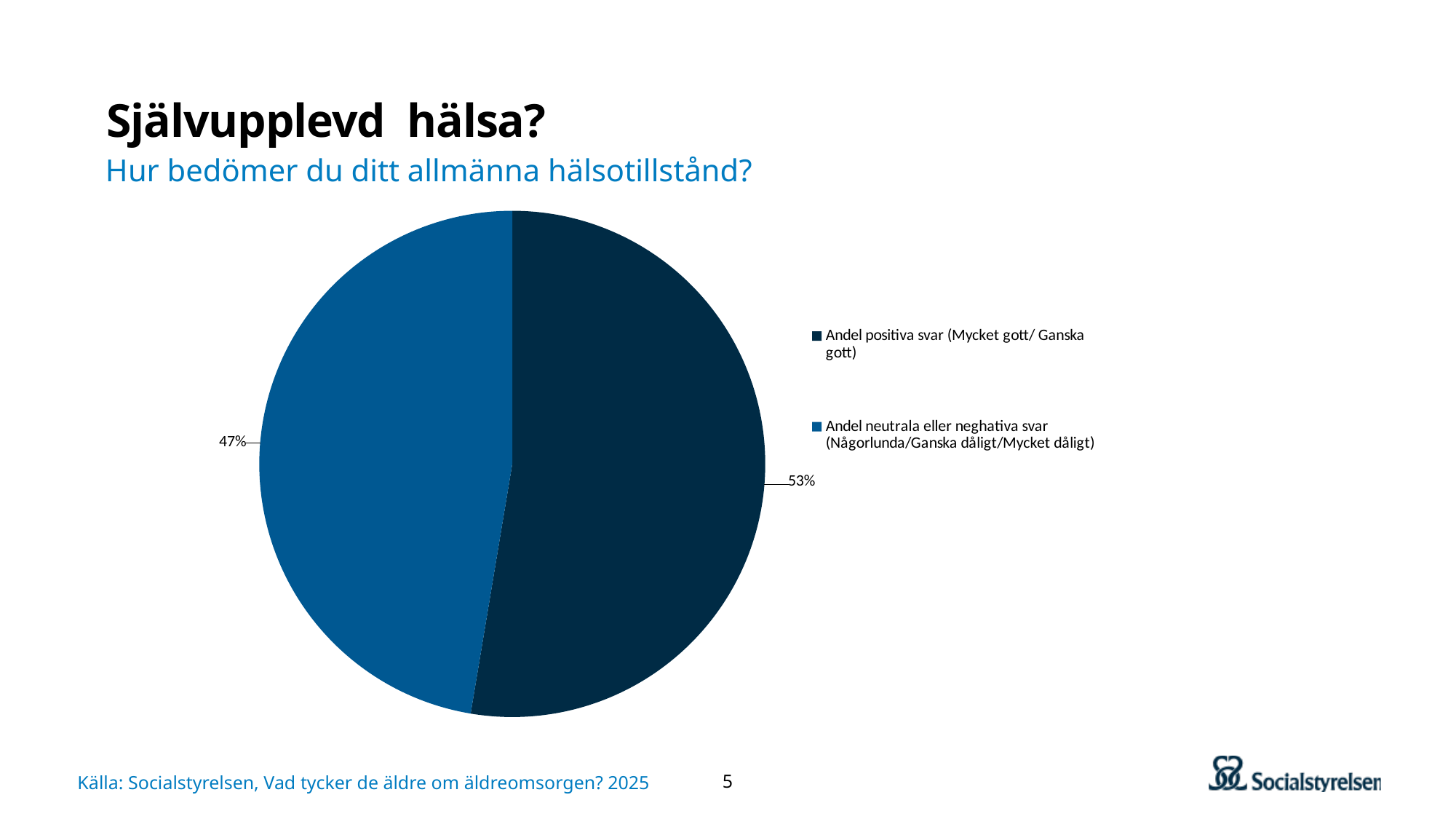
Which slice of the pie is the largest? Andel positiva svar (Mycket gott/ Ganska gott) What is the total of the two percentages shown on the pie chart? 100% What share of the pie is labelled for 'Andel positiva svar (Mycket gott/ Ganska gott)'? 53% How many slices does the pie chart have? 2 What question is shown as the subtitle above the chart? Hur bedömer du ditt allmänna hälsotillstånd? What is the difference in percentage points between the positive-answer slice and the neutral/negative-answer slice? 6 percentage points Which is larger: the share of positive answers or the share of neutral or negative answers? Positive answers (53%) How many entries does the legend list? 2 What share of the pie is labelled for 'Andel neutrala eller neghativa svar (Någorlunda/Ganska dåligt/Mycket dåligt)'? 47% What colour is the slice representing 'Andel positiva svar'? Dark navy blue What kind of chart is shown on the slide? Pie chart Which slice of the pie is the smallest? Andel neutrala eller neghativa svar (Någorlunda/Ganska dåligt/Mycket dåligt)